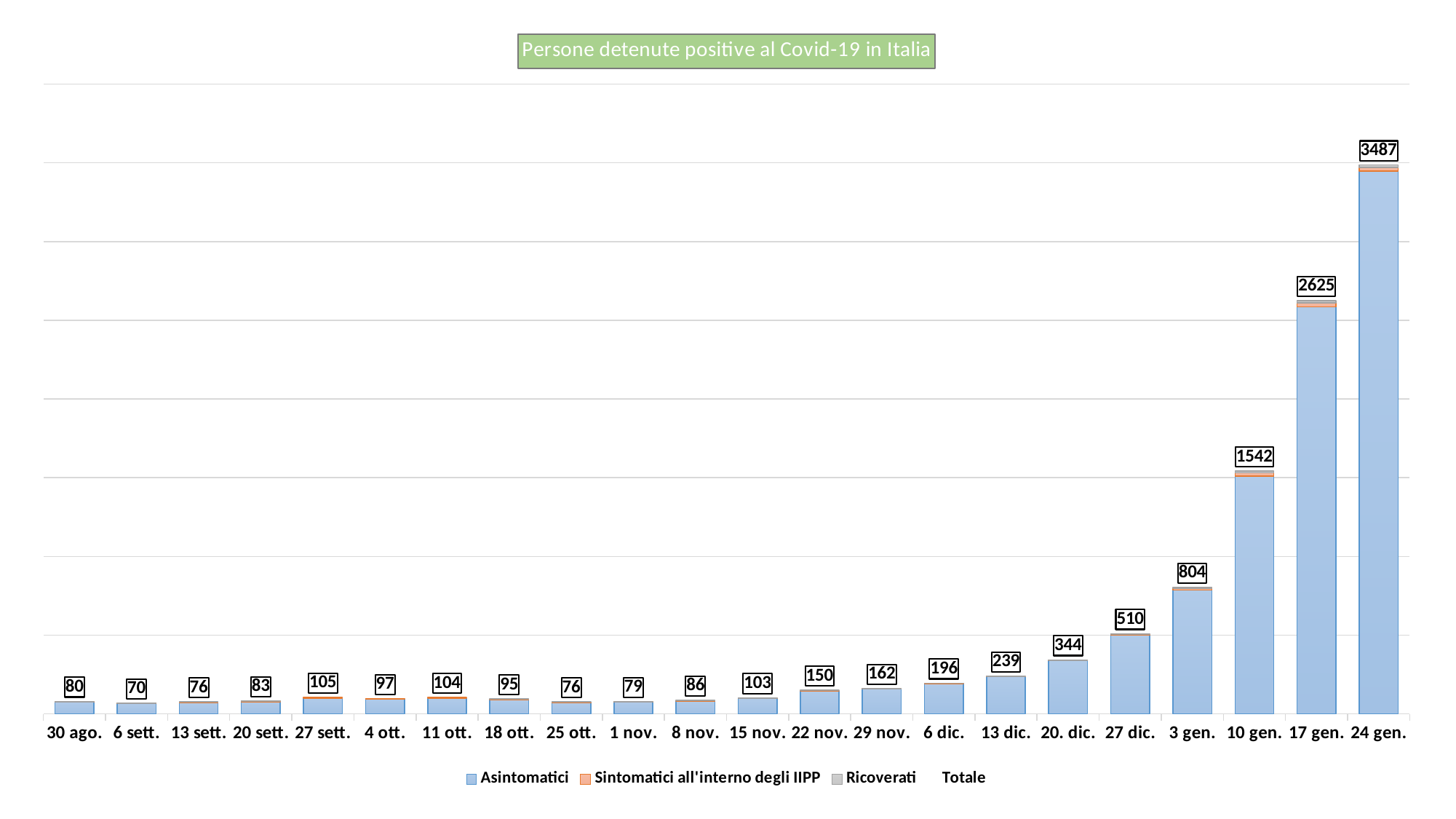
How many dates are shown on the x axis? 22 What is the total value shown for 10 gen.? 1542 How many entries does the legend list? 4 What is the total value shown for 27 sett.? 105 What is the total value shown for 24 gen.? 3487 What is the difference between the totals for 3 gen. and 27 dic.? 294 What is the difference between the totals for 24 gen. and 17 gen.? 862 Which has a larger total, 13 dic. or 20. dic.? 20. dic. Which date has the lowest total? 6 sett. What kind of chart is this? bar chart Which date has the highest total? 24 gen. What is the title of the chart? Persone detenute positive al Covid-19 in Italia